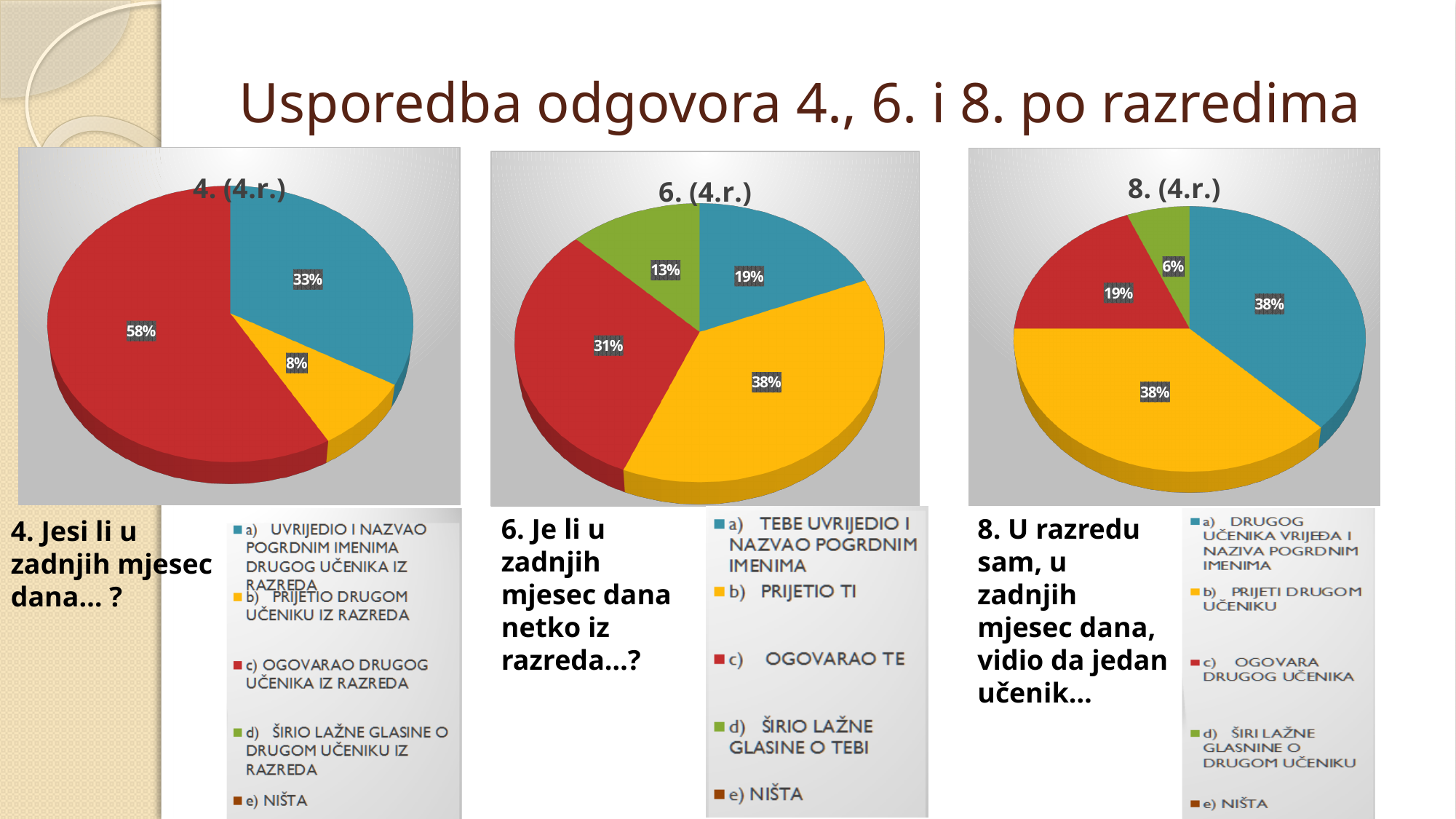
Comparing the blue slice (a) in the "4. (4.r.)" chart and the blue slice (a) in the "8. (4.r.)" chart, which is larger? 8. (4.r.) (38% vs 33%) In the pie chart titled "4. (4.r.)", what percentage is shown for the red slice (c) OGOVARAO DRUGOG UČENIKA IZ RAZREDA)? 58% In the pie chart titled "6. (4.r.)", what percentage is shown for the green slice (d) ŠIRIO LAŽNE GLASINE O TEBI)? 13% In the pie chart titled "6. (4.r.)", which slice is the largest? b) PRIJETIO TI (38%) In the pie chart titled "6. (4.r.)", what is the difference between the yellow slice (38%) and the blue slice (19%)? 19 percentage points In the pie chart titled "8. (4.r.)", what percentage is shown for the red slice (c) OGOVARA DRUGOG UČENIKA)? 19% In the pie chart titled "4. (4.r.)", which slice is the largest? c) OGOVARAO DRUGOG UČENIKA IZ RAZREDA (58%) In the pie chart titled "8. (4.r.)", which slice is the smallest? d) ŠIRI LAŽNE GLASNINE O DRUGOM UČENIKU (6%) How many slices with data labels are visible in the pie chart titled "6. (4.r.)"? 4 In the pie chart titled "4. (4.r.)", what percentage is shown for the yellow slice (b) PRIJETIO DRUGOM UČENIKU IZ RAZREDA)? 8% In the pie chart titled "8. (4.r.)", what percentage is shown for the green slice (d) ŠIRI LAŽNE GLASNINE O DRUGOM UČENIKU)? 6% What type of chart is used for each of the three charts on the slide? Pie chart